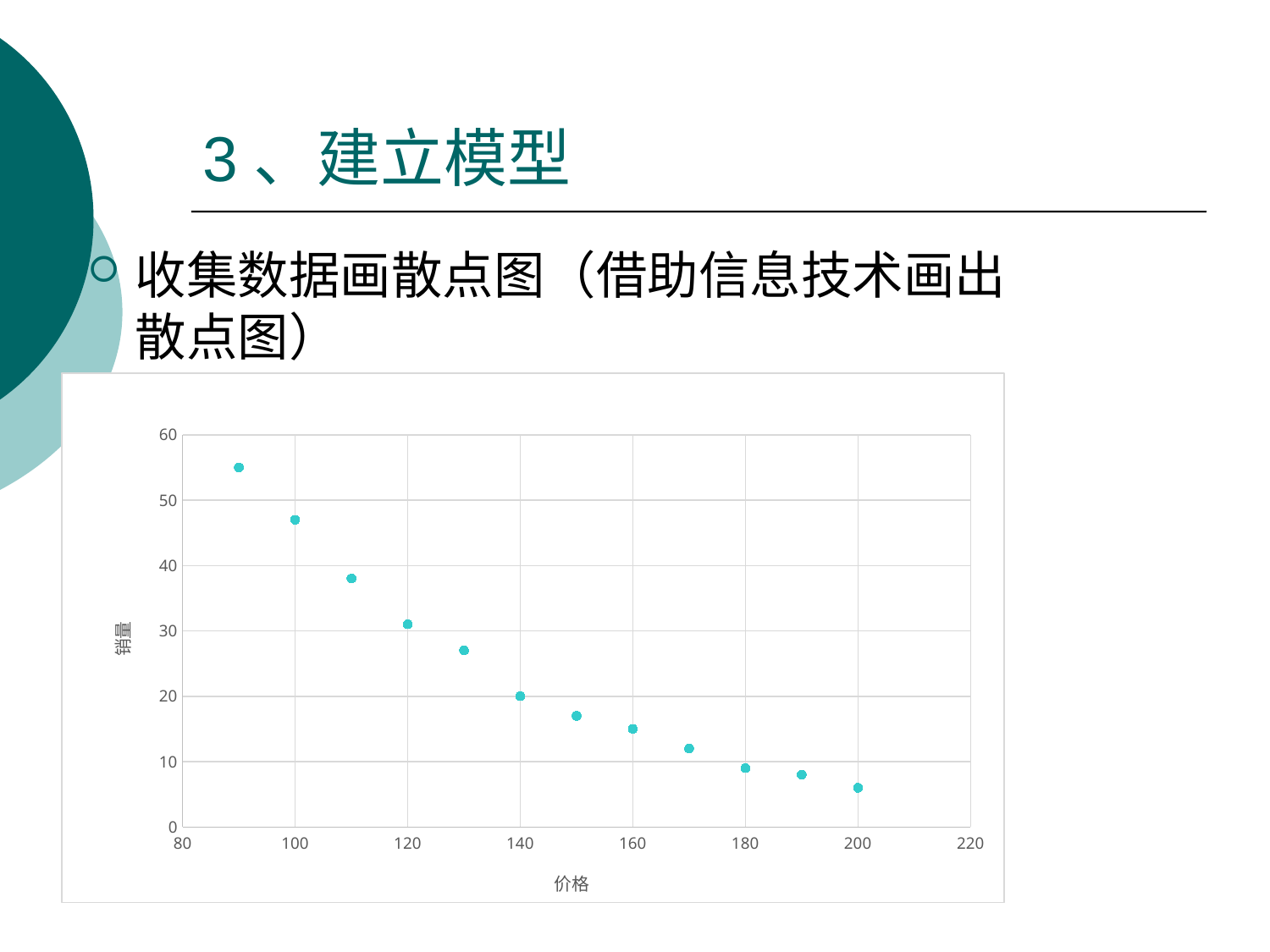
As 价格 increases along the x axis, do the 销量 values rise or fall? fall Is the 销量 value at 价格 100 greater or less than 40? greater Is the 销量 value at 价格 180 greater or less than 20? less Which has the larger 销量 value, 价格 140 or 价格 160? 140 What is the title of the x axis? 价格 Which 价格 value has the lowest 销量? 200 Is the 销量 value at 价格 200 greater or less than 10? less What is the 销量 value at 价格 140? 20 How many data points are plotted on the chart? 12 What is the title of the y axis? 销量 What kind of chart is shown on the slide? scatter chart